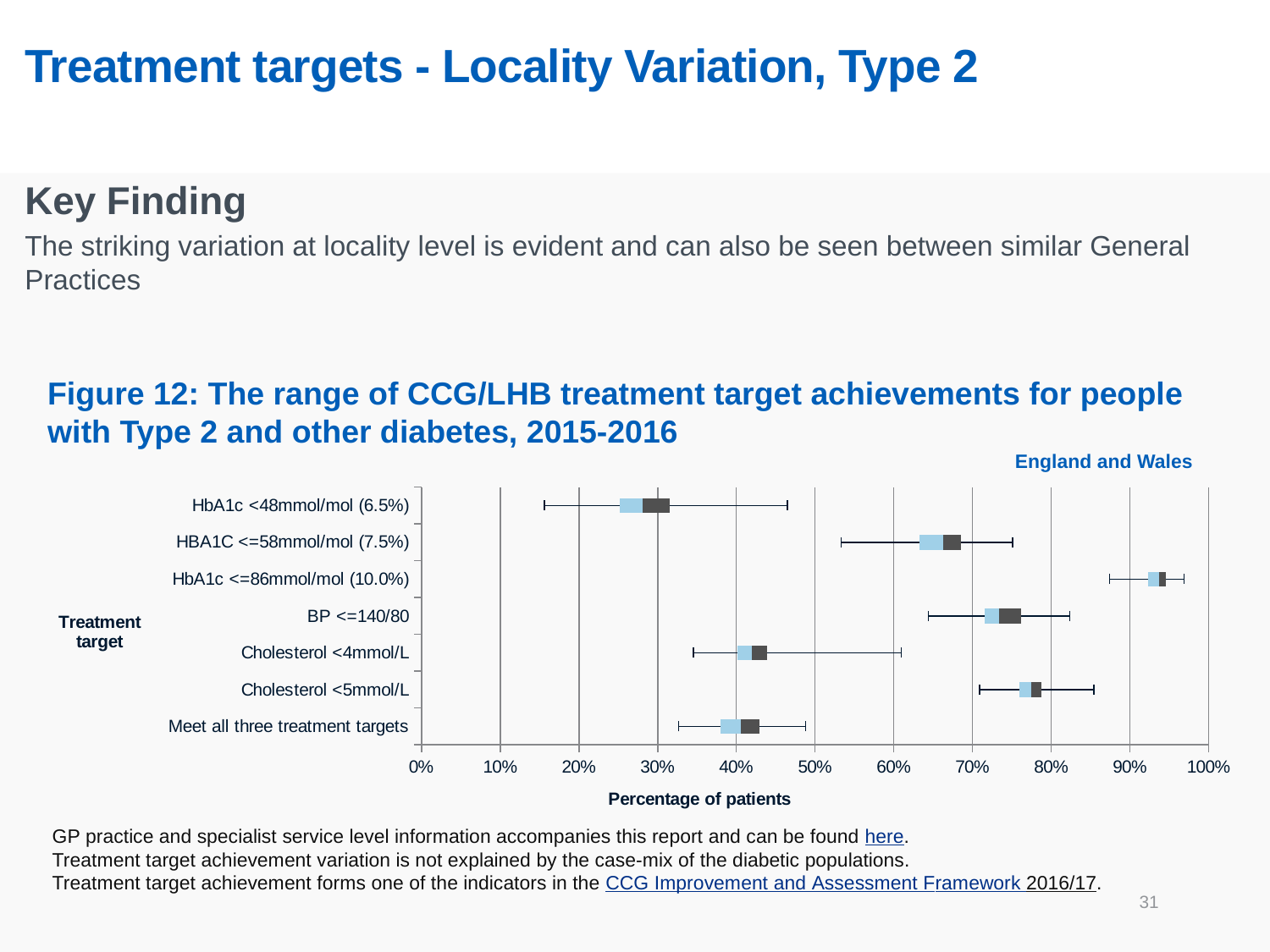
Is the central value for HbA1c <48mmol/mol (6.5%) greater or less than 40%? less Is the central value for HBA1C <=58mmol/mol (7.5%) greater or less than 60%? greater Is the central value for BP <=140/80 greater or less than 70%? greater Which has the higher achievement: Cholesterol <5mmol/L or Cholesterol <4mmol/L? Cholesterol <5mmol/L How many treatment targets are plotted on the y axis of Figure 12? 7 Which geographic area does Figure 12 cover, according to the label above the chart? England and Wales Which treatment target has the lowest achievement range in Figure 12? HbA1c <48mmol/mol (6.5%) Which treatment target has the highest achievement range in Figure 12? HbA1c <=86mmol/mol (10.0%) What kind of chart is shown in Figure 12? Box-and-whisker (range) chart What is the label of the x axis in Figure 12? Percentage of patients